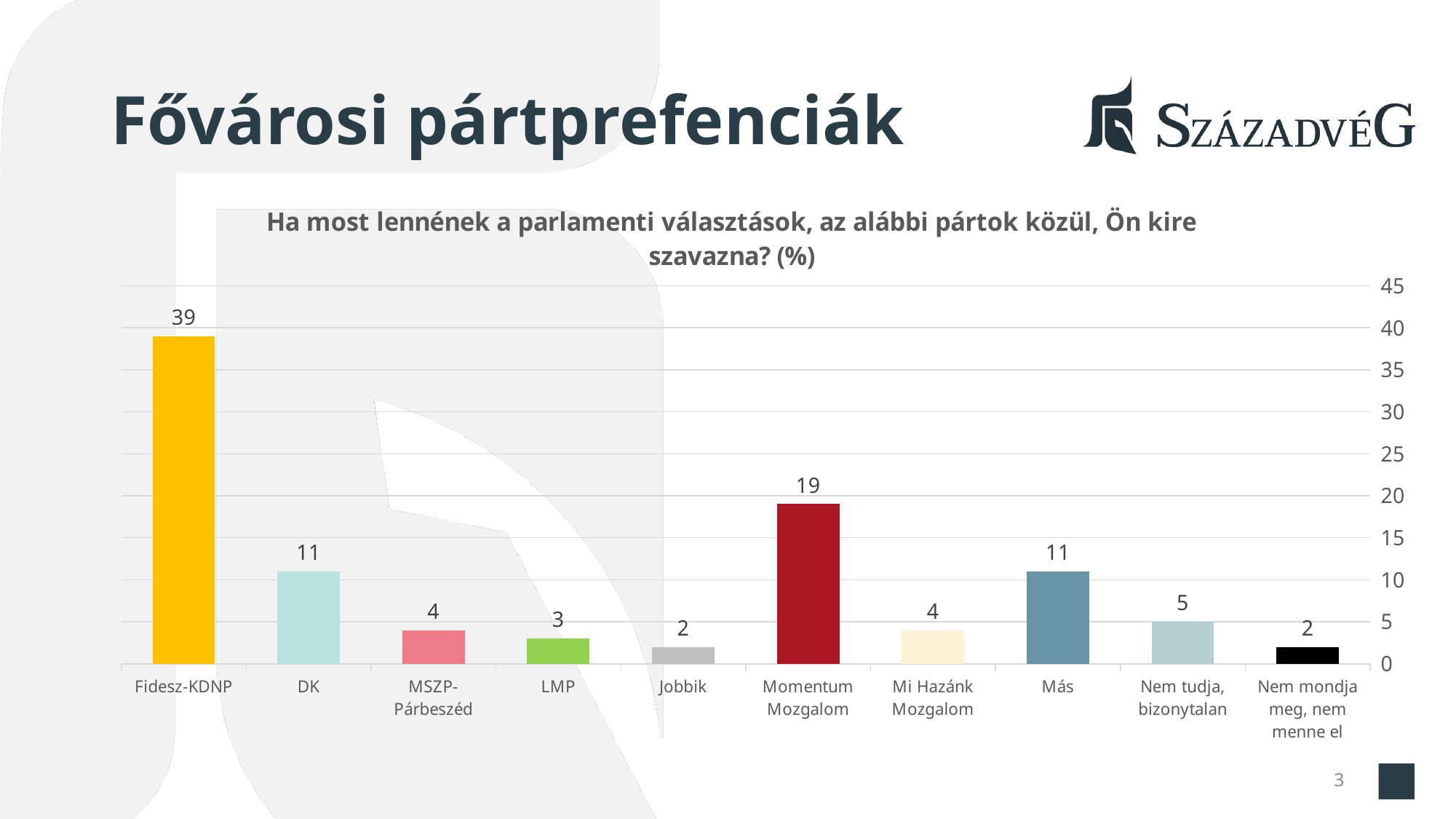
What colour is the bar for Fidesz-KDNP? yellow How many categories are shown on the x axis? 10 What is the value for Fidesz-KDNP? 39 Is the value for Fidesz-KDNP greater or less than 35? greater Which is larger, the value for Momentum Mozgalom or the value for Más? Momentum Mozgalom What is the value for Nem tudja, bizonytalan? 5 What is the difference between the values for Fidesz-KDNP and Momentum Mozgalom? 20 What is the difference between the values for DK and MSZP-Párbeszéd? 7 What is the value for LMP? 3 Which category has the highest value? Fidesz-KDNP What is the value for Momentum Mozgalom? 19 What kind of chart is shown on the slide? bar chart